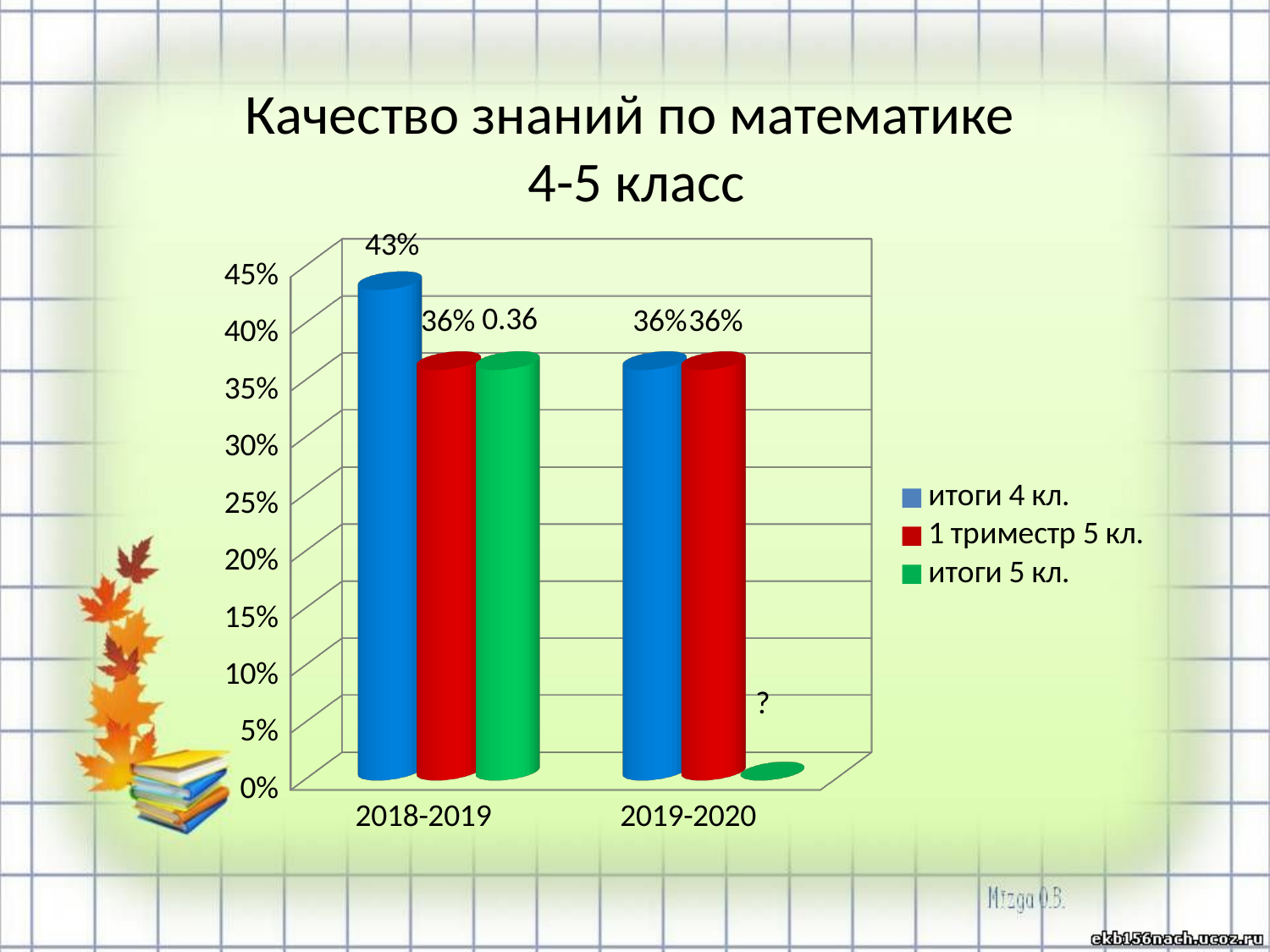
What is the value for итоги 4 кл. in 2019-2020? 36% What data label is shown for итоги 5 кл. in 2018-2019? 0.36 How many series does the legend list? 3 Which series has the highest value in 2018-2019? итоги 4 кл. How many categories are shown on the x axis? 2 What is the title of the chart? Качество знаний по математике 4-5 класс What data label is shown for итоги 5 кл. in 2019-2020? ? What type of chart is shown on the slide? bar chart What is the value for 1 триместр 5 кл. in 2018-2019? 36% What is the difference between итоги 4 кл. in 2018-2019 and итоги 4 кл. in 2019-2020? 7% Which is larger: итоги 4 кл. in 2018-2019 or 1 триместр 5 кл. in 2018-2019? итоги 4 кл. in 2018-2019 What is the value for итоги 4 кл. in 2018-2019? 43%